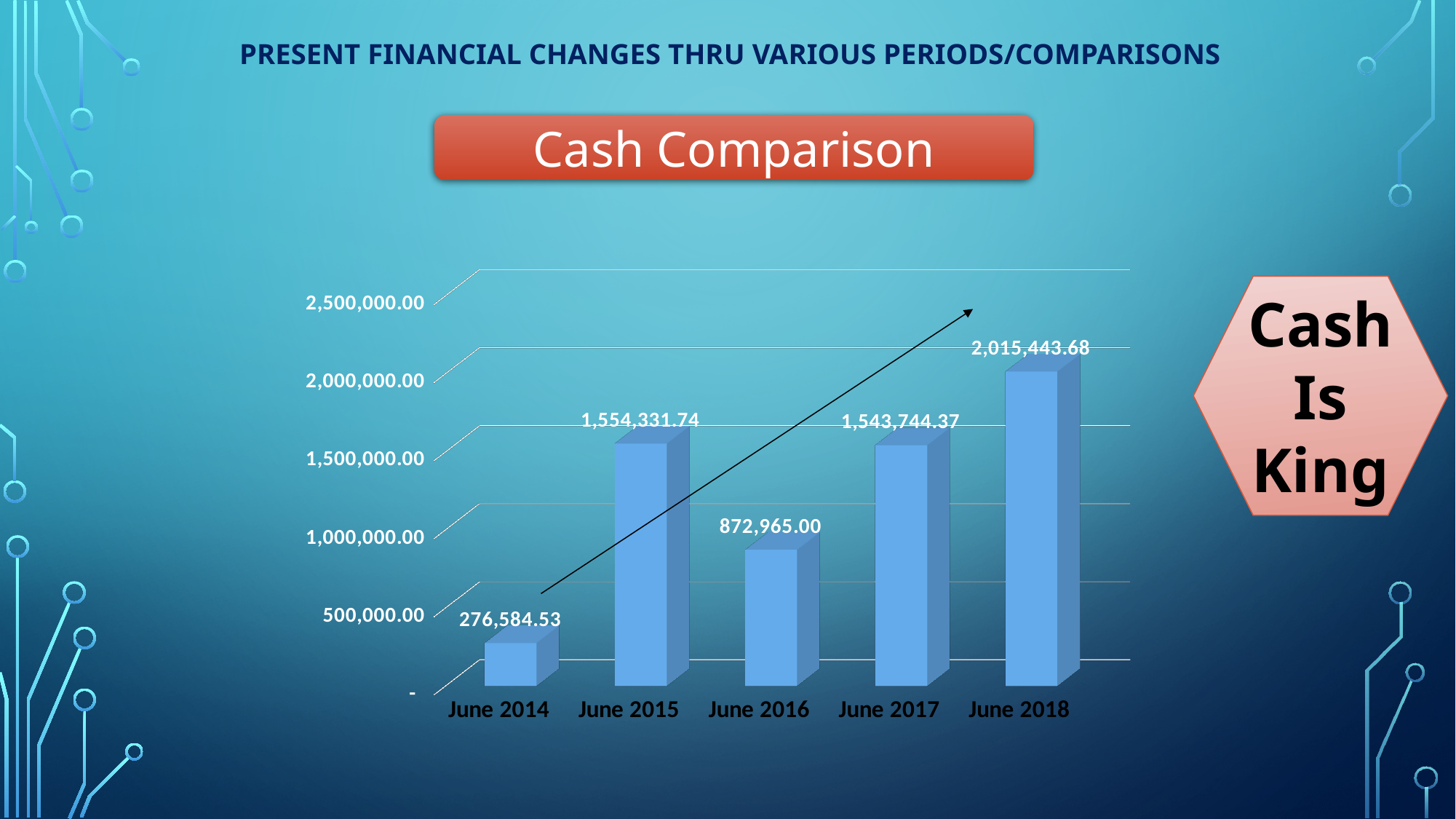
What is the difference between the cash values for June 2018 and June 2014? 1,738,859.15 Which period has the highest cash value? June 2018 What is the cash value shown for June 2018 in the Cash Comparison chart? 2,015,443.68 What is the cash value shown for June 2016? 872,965.00 Does the cash value rise or fall from June 2017 to June 2018? Rise Which period has the lowest cash value? June 2014 What is the cash value shown for June 2014? 276,584.53 How many periods are shown on the x axis of the chart? 5 What kind of chart is used for the Cash Comparison? Bar chart Which is larger, the cash value for June 2015 or June 2017? June 2015 Is the cash value for June 2016 greater or less than 1,000,000.00? less What is the difference between the cash values for June 2015 and June 2016? 681,366.74